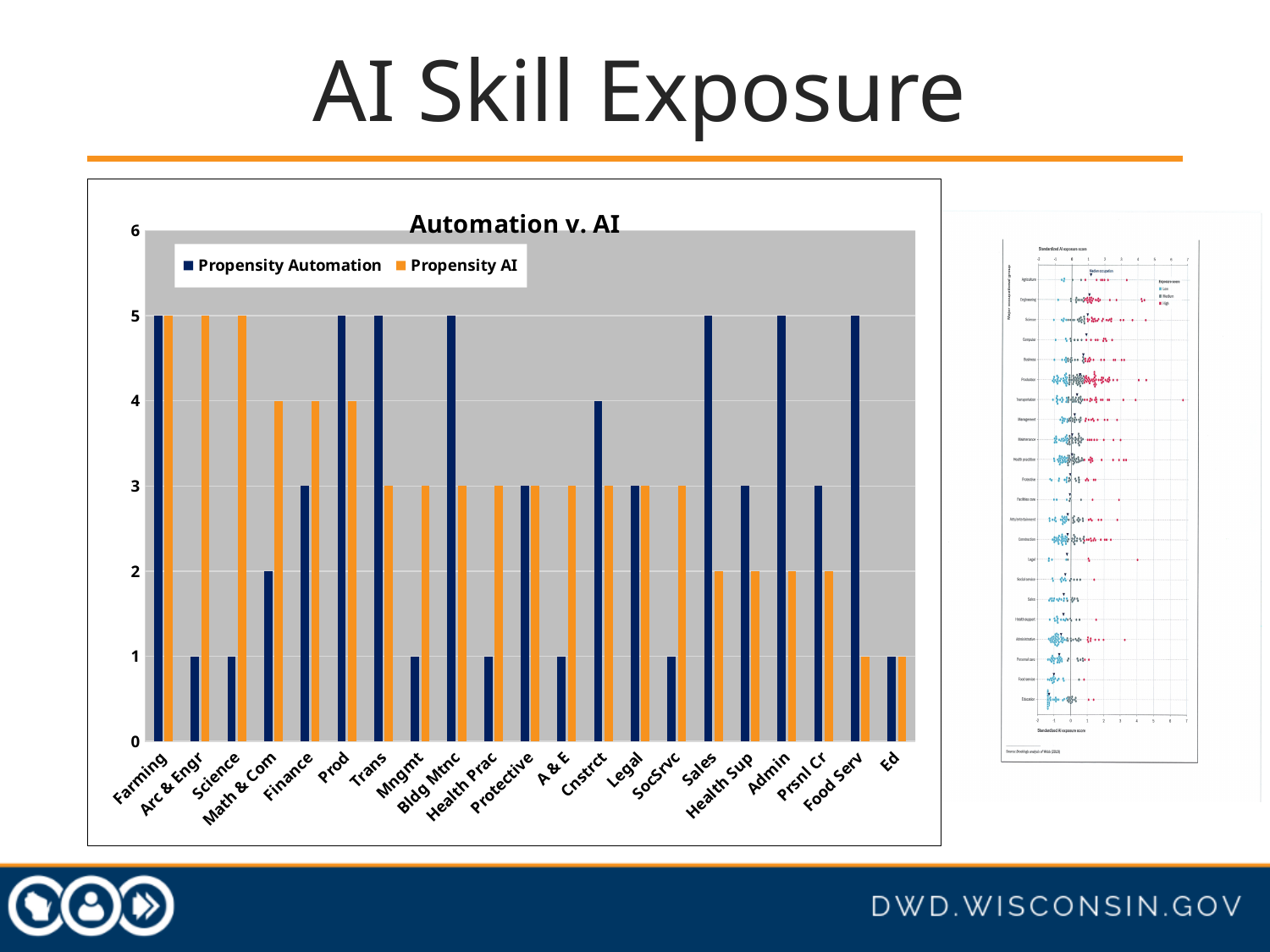
How many categories are shown on the x axis of the 'Automation v. AI' chart? 21 In the 'Automation v. AI' chart, which is larger for Sales: Propensity Automation or Propensity AI? Propensity Automation In the 'Automation v. AI' chart, what is the difference between the Propensity AI and Propensity Automation values for Science? 4 In the 'Automation v. AI' chart, is the Propensity Automation value for Trans greater or less than 3? greater In the 'Automation v. AI' chart, what is the Propensity AI value for Arc & Engr? 5 What kind of chart is the 'Automation v. AI' chart? Bar chart In the 'Automation v. AI' chart, which is larger for Finance: Propensity Automation or Propensity AI? Propensity AI In the 'Automation v. AI' chart, what is the Propensity Automation value for Math & Com? 2 In the 'Automation v. AI' chart, which colour represents Propensity AI? Orange In the 'Automation v. AI' chart, what is the Propensity AI value for Food Serv? 1 In the 'Automation v. AI' chart, what is the Propensity Automation value for Cnstrct? 4 How many series does the legend of the 'Automation v. AI' chart list? 2